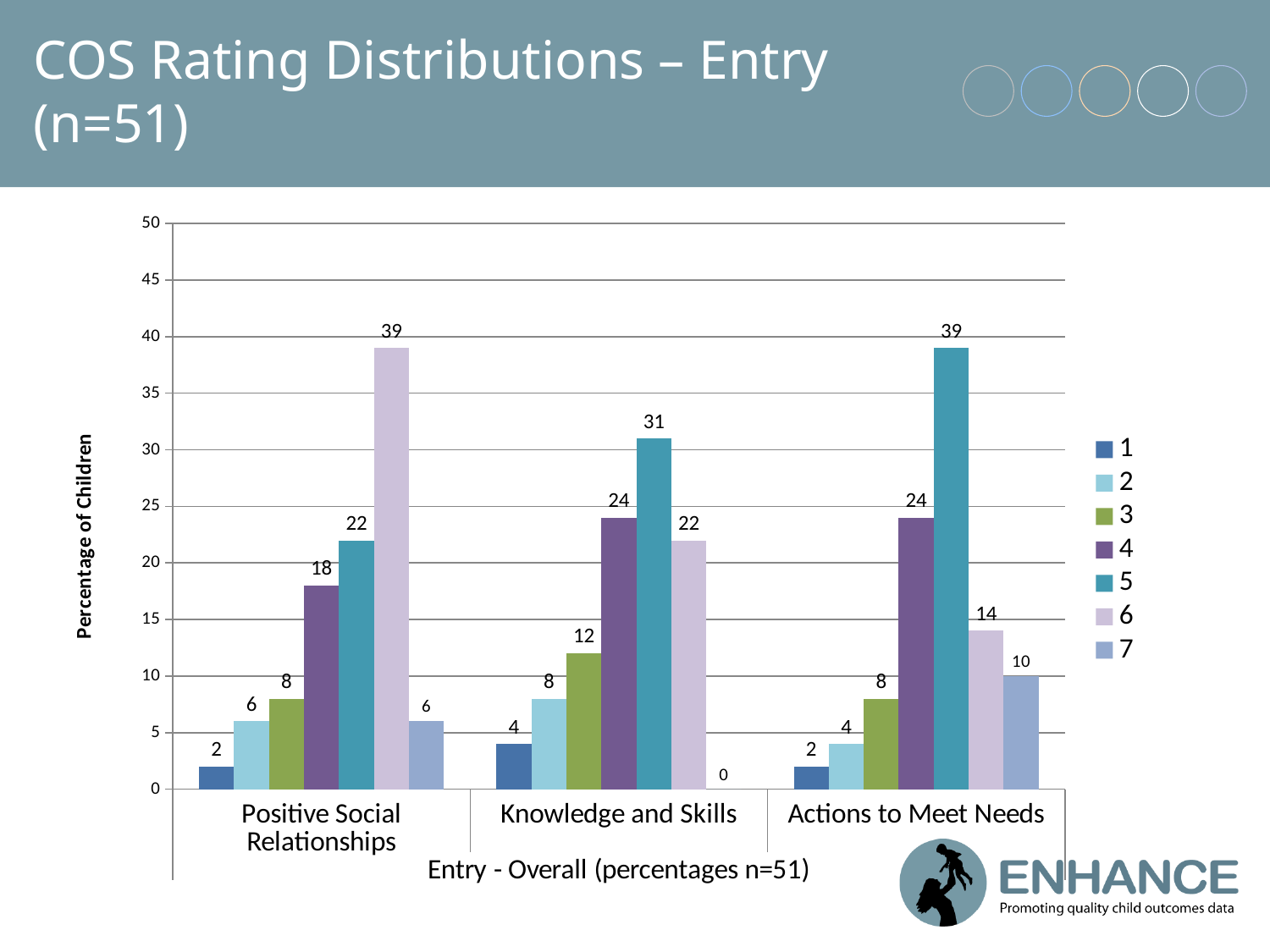
What is the label of the y axis? Percentage of Children Which is larger: the value for rating 4 in Knowledge and Skills or the value for rating 4 in Positive Social Relationships? Knowledge and Skills How many categories are shown on the x axis? 3 What is the value for rating 7 in the Actions to Meet Needs category? 10 What is the value for rating 5 in the Knowledge and Skills category? 31 What is the difference between the values for rating 6 and rating 5 in the Positive Social Relationships category? 17 What is the value for rating 6 in the Positive Social Relationships category? 39 What kind of chart is shown on the slide? Bar chart Which rating has the highest value in the Actions to Meet Needs category? 5 How many series does the legend list? 7 What is the value for rating 7 in the Knowledge and Skills category? 0 Which rating has the lowest value in the Positive Social Relationships category? 1